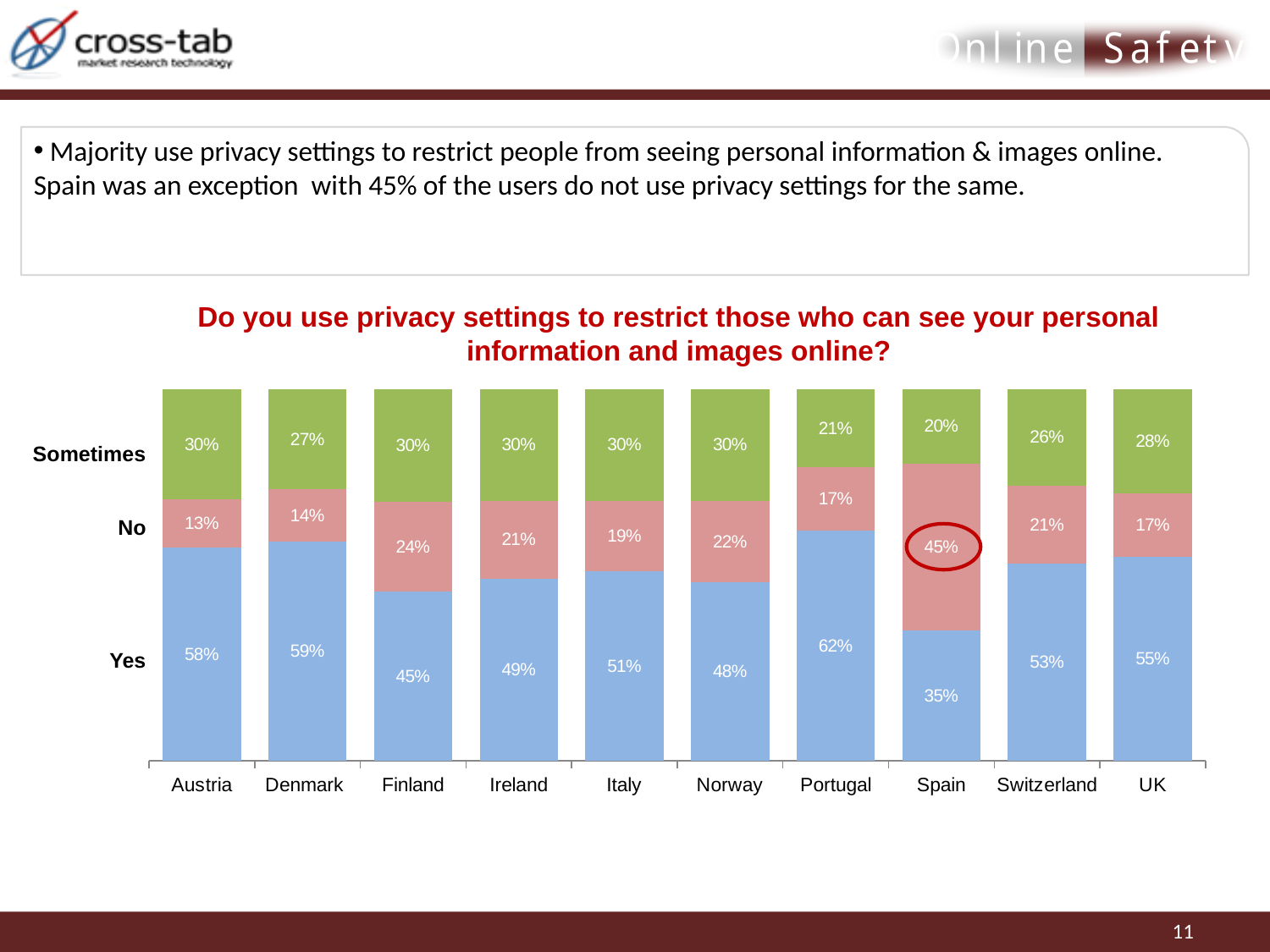
What is the difference between the "No" value for Spain and the "No" value for Austria? 32 percentage points Which country has the highest "Yes" percentage? Portugal Which is larger, the "Yes" value for Denmark or the "Yes" value for Switzerland? Denmark What is the "Yes" value for Portugal? 62% What is the total of the stacked bar for Spain? 100% What is the "No" value for Finland? 24% What is the "Sometimes" value for Denmark? 27% How many countries are shown on the x axis of the chart? 10 Which country has the lowest "Yes" percentage? Spain What percentage of users in Spain answered "No" to using privacy settings? 45% How many response categories (series) are stacked in each bar? 3 What kind of chart is shown on the slide? Stacked bar chart